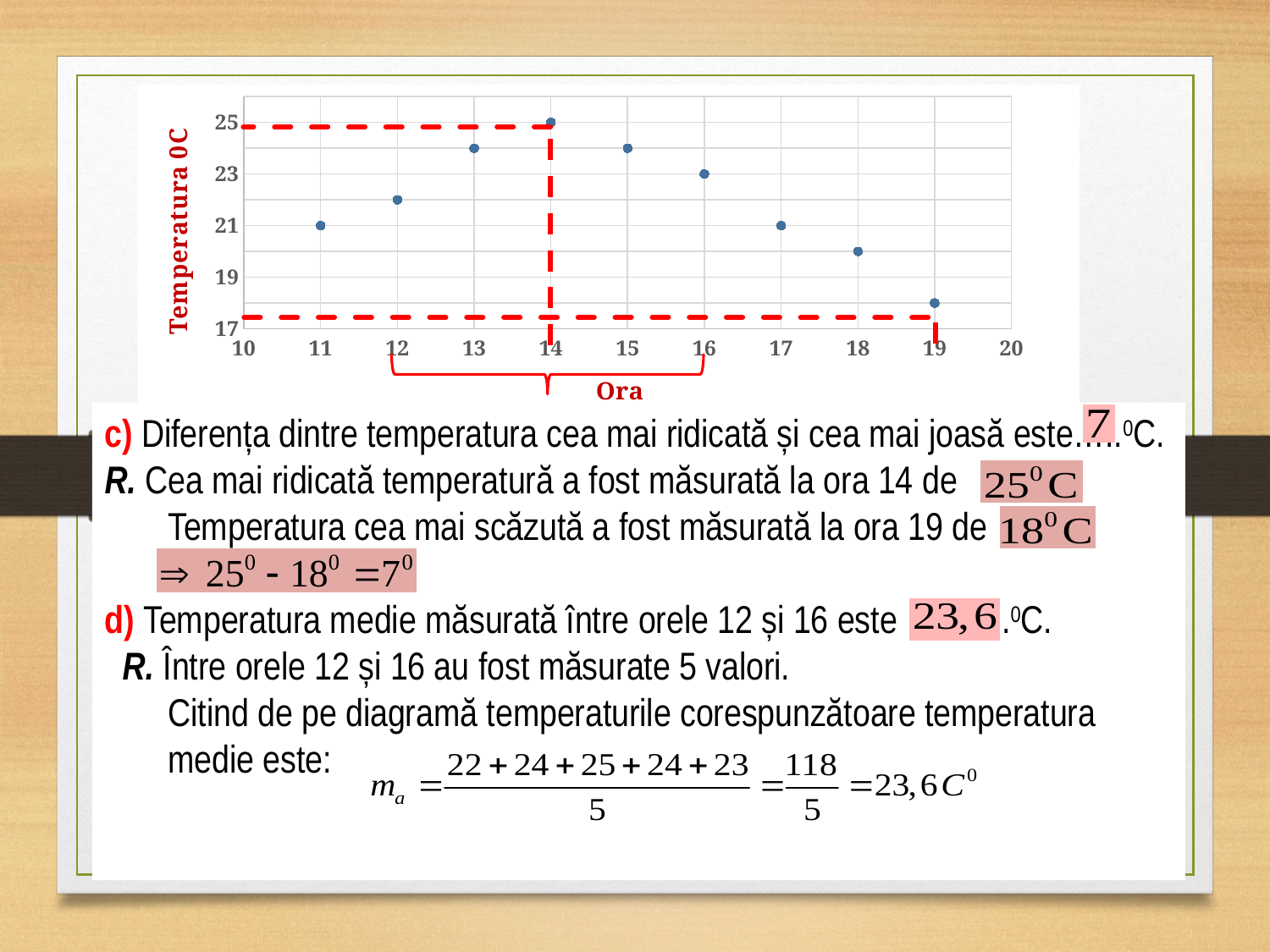
What temperature was recorded at hour 11? 21 At which hour (Ora) was the highest temperature recorded? 14 What temperature was recorded at hour 16? 23 Do the temperatures rise or fall from hour 14 to hour 19? fall At which hour (Ora) was the lowest temperature recorded? 19 What temperature was recorded at hour 14? 25 What kind of chart is shown on the slide? scatter chart Is the temperature at hour 13 greater or less than 23? greater What is the difference between the highest and the lowest temperature on the chart? 7 Which is higher, the temperature at hour 15 or at hour 17? hour 15 How many data points are plotted on the chart? 9 Is the temperature at hour 18 greater or less than 21? less